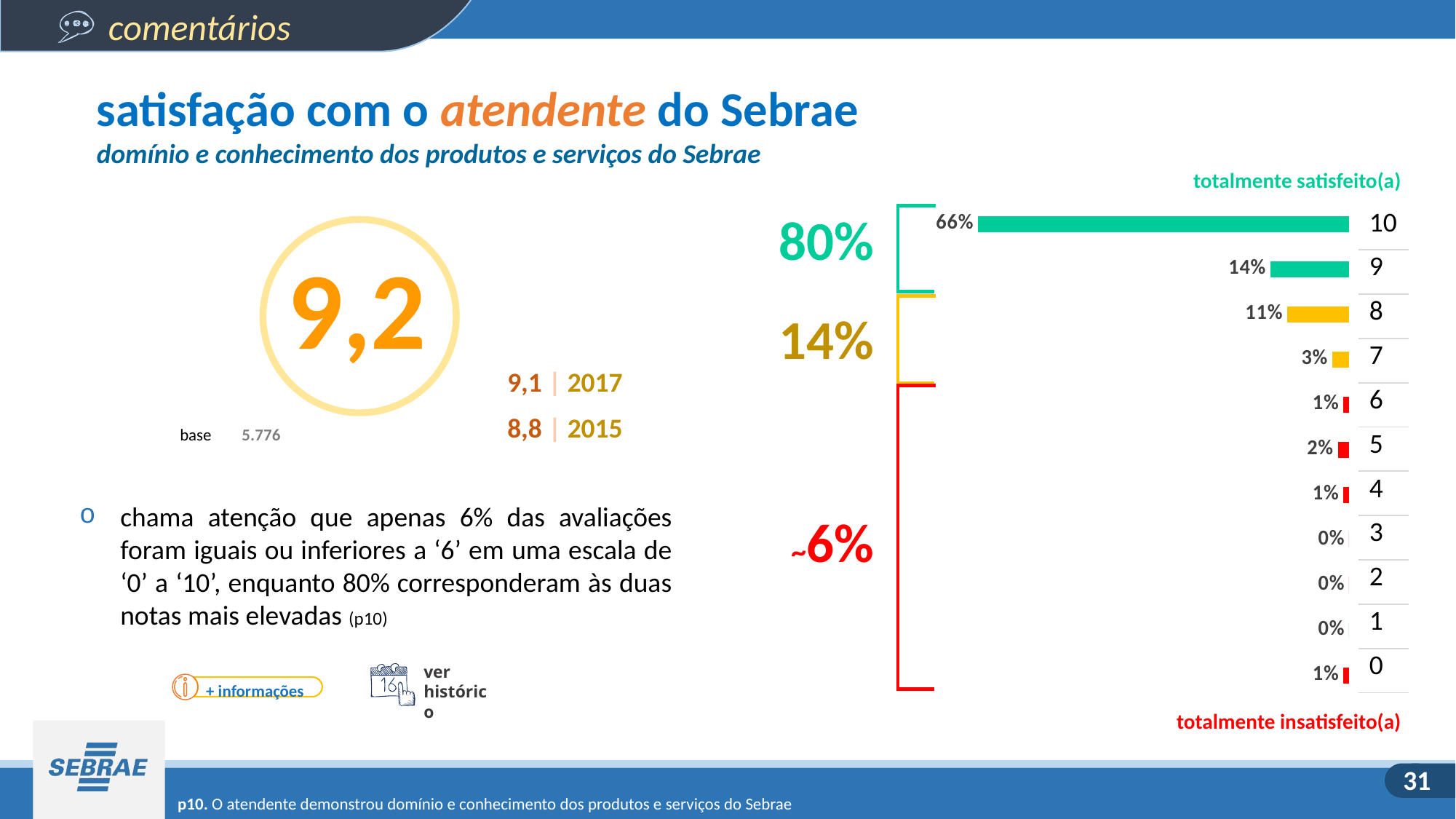
What percentage of respondents gave a score of 5? 2% What percentage of respondents gave a score of 0? 1% What percentage of respondents gave a score of 8? 11% What percentage of respondents gave a score of 10? 66% Which score has a larger percentage, 8 or 9? 9 Which score has the highest percentage of respondents? 10 What label appears at the top of the chart above the score 10 bar? totalmente satisfeito(a) What is the combined percentage for scores 9 and 10? 80% How many score categories are shown in the bar chart? 11 What colour are the bars for scores 9 and 10? green What is the difference in percentage points between the score 10 bar and the score 9 bar? 52 What kind of chart is used to show the distribution of scores? bar chart